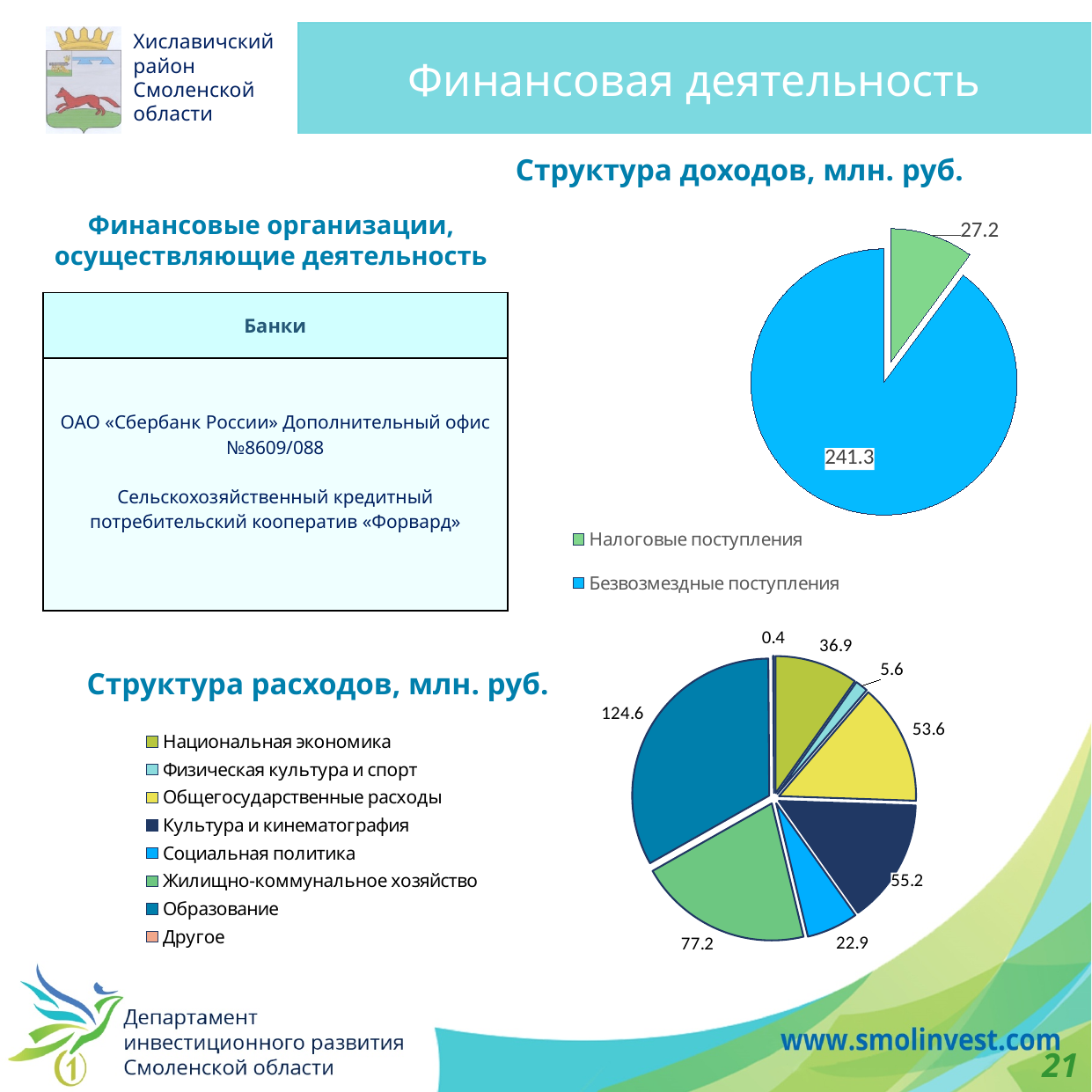
In the 'Структура расходов, млн. руб.' pie chart, what is the value for Общегосударственные расходы? 53.6 In the 'Структура расходов, млн. руб.' pie chart, what is the difference between Образование and Социальная политика? 101.7 In the 'Структура доходов, млн. руб.' pie chart, what is the value for Налоговые поступления? 27.2 How many categories does the legend of the 'Структура расходов, млн. руб.' chart list? 8 In the 'Структура расходов, млн. руб.' pie chart, which category has the smallest value? Другое In the 'Структура доходов, млн. руб.' pie chart, what is the value for Безвозмездные поступления? 241.3 In the 'Структура расходов, млн. руб.' pie chart, what is the value for Образование? 124.6 What kind of chart is used for 'Структура расходов, млн. руб.'? Pie chart In the 'Структура доходов, млн. руб.' pie chart, what is the difference between Безвозмездные поступления and Налоговые поступления? 214.1 In the 'Структура расходов, млн. руб.' pie chart, which is larger: Жилищно-коммунальное хозяйство or Культура и кинематография? Жилищно-коммунальное хозяйство In the 'Структура доходов, млн. руб.' pie chart, which category is the largest? Безвозмездные поступления How many entries does the legend of the 'Структура доходов, млн. руб.' chart list? 2